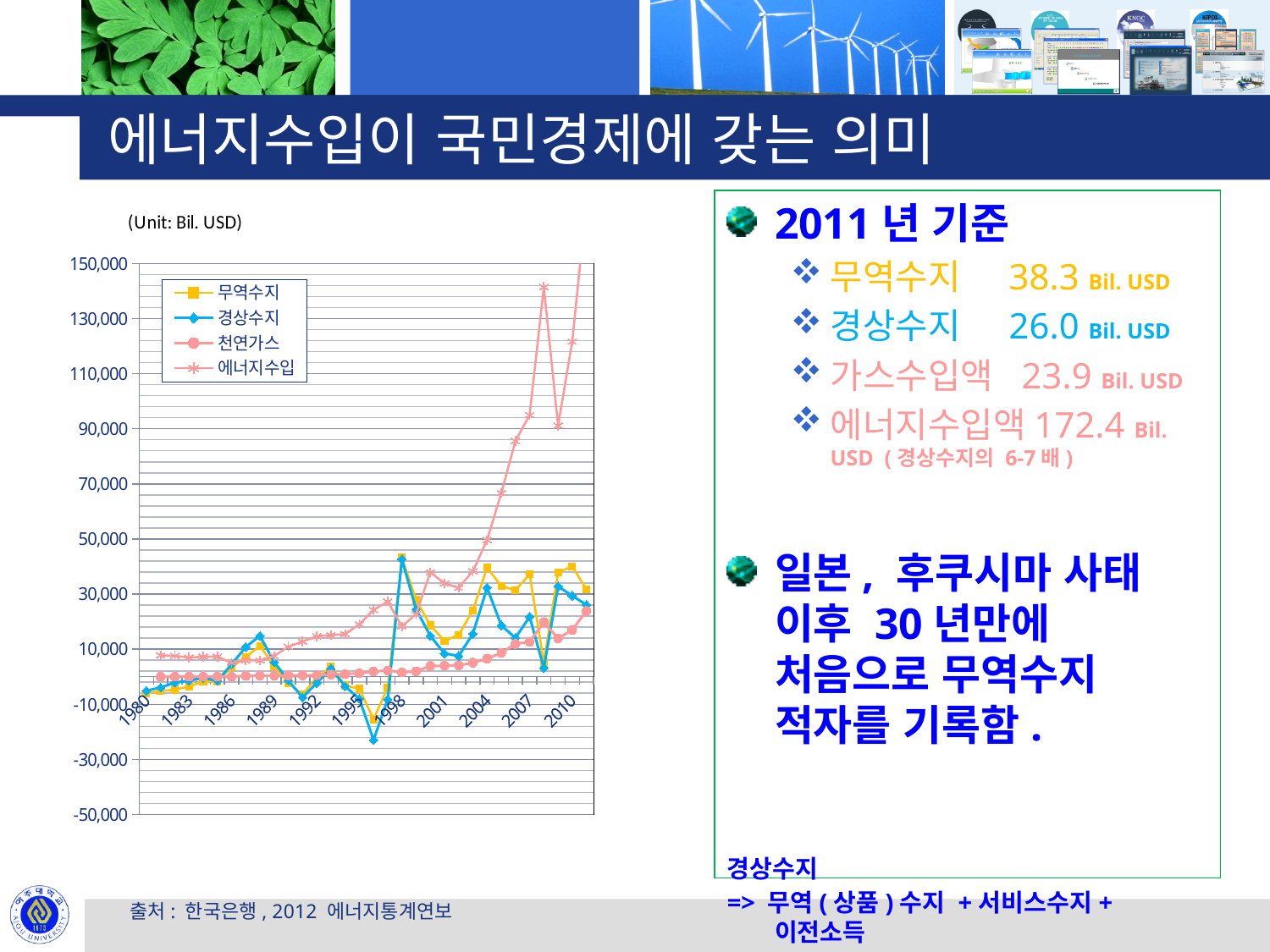
Does the 에너지수입 series generally rise or fall from 1980 to 2010? rise What is the lowest value shown on the chart's y axis? -50,000 How many series does the chart's legend list? 4 Is the lowest point of the 경상수지 series greater or less than -10,000? less How many year labels are shown on the chart's x axis? 11 What are the four series listed in the chart's legend? 무역수지, 경상수지, 천연가스, 에너지수입 Which series has the highest value at the right end of the chart (2010 and after)? 에너지수입 What kind of chart is shown on the slide? line chart What unit is stated above the chart? Bil. USD Is the value for 에너지수입 in 2010 greater or less than 90,000? greater What is the highest value shown on the chart's y axis? 150,000 Which series reaches the lowest value on the chart, in the dip around 1997? 경상수지